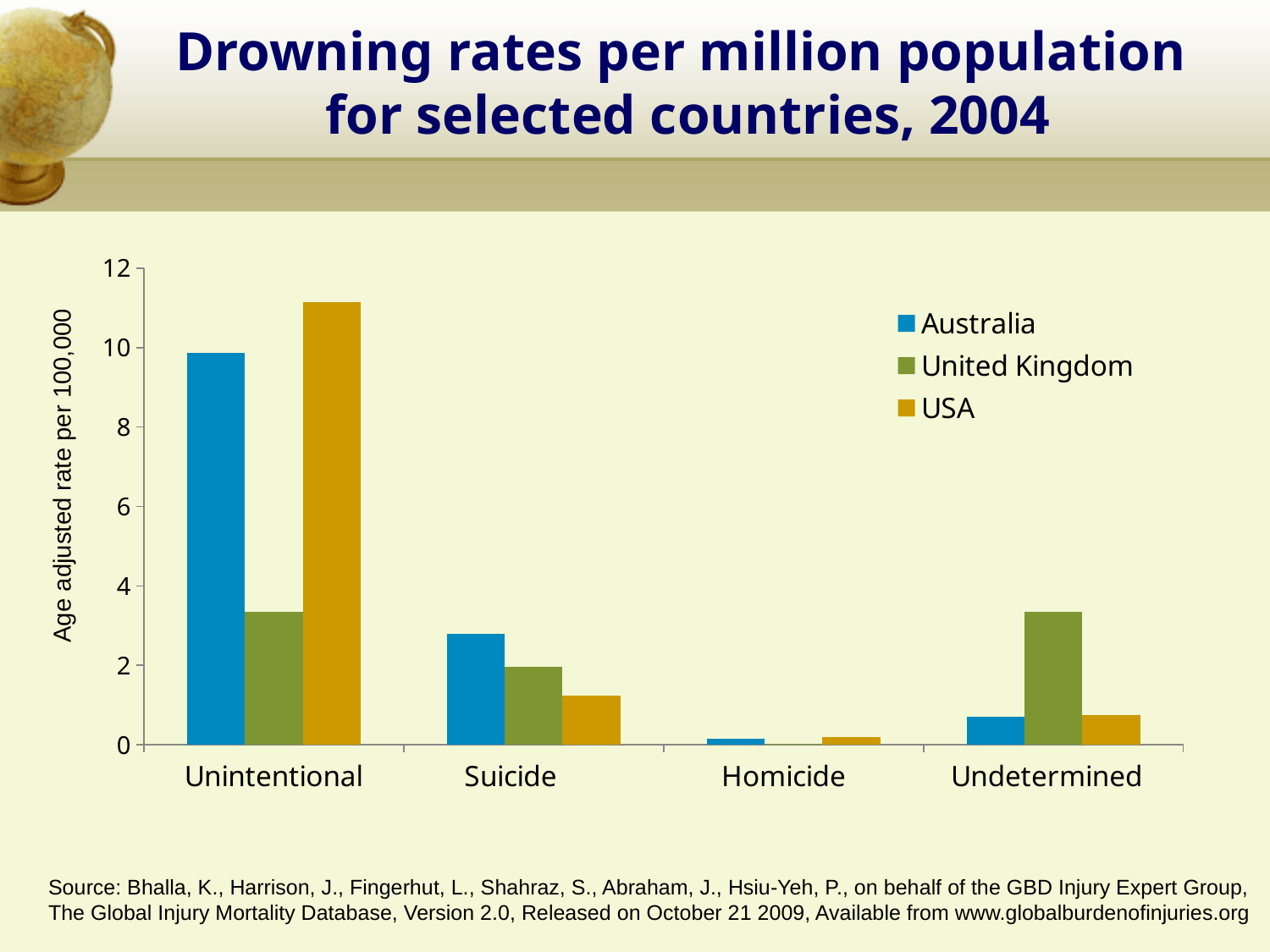
How many series does the legend list? 3 Is the value for the United Kingdom in the Unintentional category greater or less than 4? less For Australia, which category has the lowest drowning rate? Homicide Which country has the highest drowning rate in the Unintentional category? USA How many categories are shown on the x axis? 4 In the Suicide category, which is larger: the rate for Australia or the rate for the United Kingdom? Australia What kind of chart is shown on the slide? Bar chart What is the label on the y axis of the chart? Age adjusted rate per 100,000 Which country has the highest drowning rate in the Undetermined category? United Kingdom Is the value for Australia in the Unintentional category greater or less than 8? greater For the USA, which category has the highest drowning rate? Unintentional Is the value for the USA in the Unintentional category greater or less than 10? greater